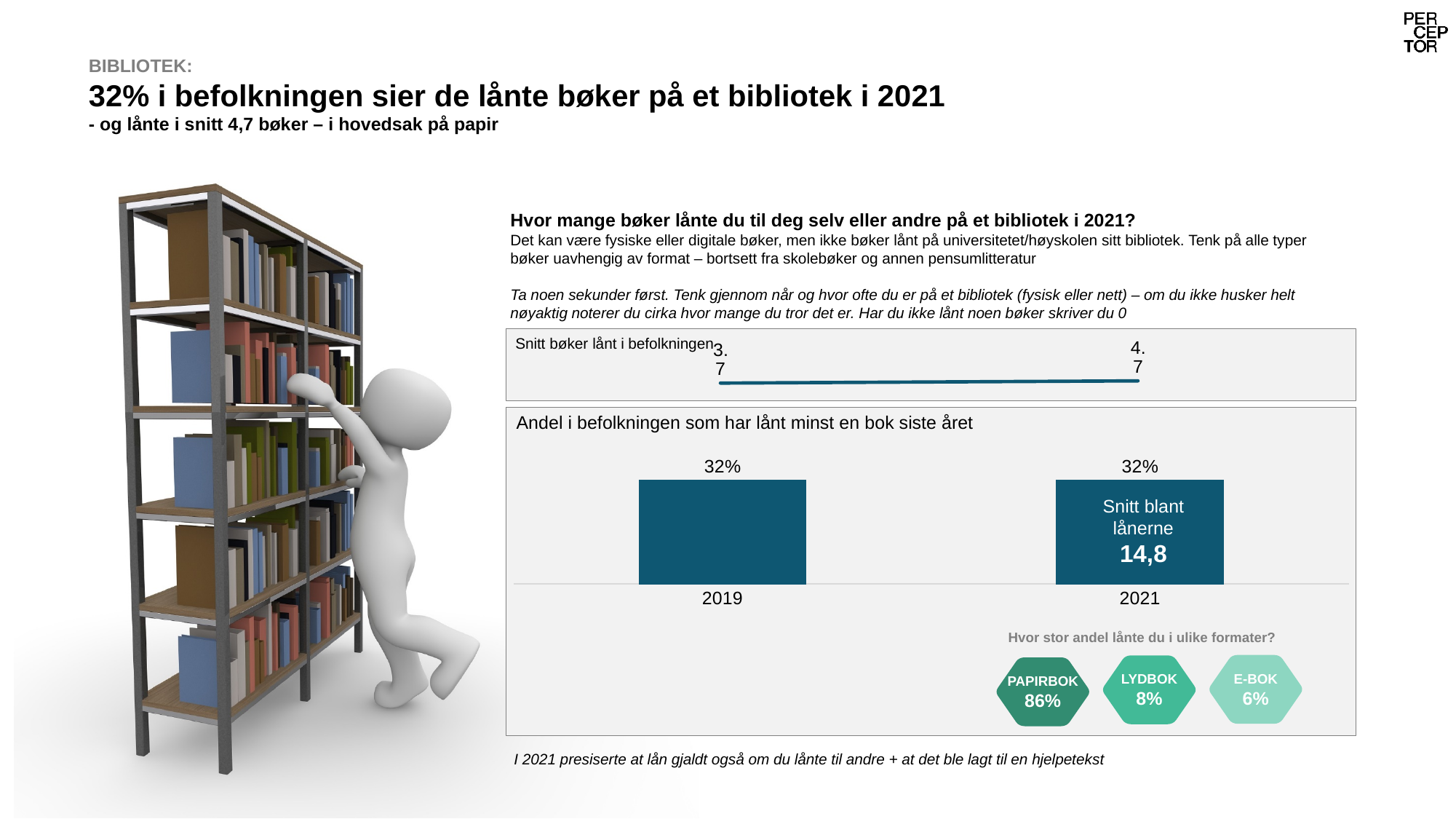
In the chart 'Snitt bøker lånt i befolkningen', does the value rise or fall from 2019 to 2021? Rises In the chart 'Andel i befolkningen som har lånt minst en bok siste året', what is the difference between the 2021 and 2019 values? 0 percentage points In the chart 'Snitt bøker lånt i befolkningen', what is the value for 2021? 4.7 In the chart 'Andel i befolkningen som har lånt minst en bok siste året', what is the value for 2019? 32% How many years are shown in the chart 'Andel i befolkningen som har lånt minst en bok siste året'? 2 In the chart 'Snitt bøker lånt i befolkningen', what is the value for 2019? 3.7 In the chart 'Andel i befolkningen som har lånt minst en bok siste året', is the value for 2019 or 2021 larger? They are equal (32%) In the chart 'Snitt bøker lånt i befolkningen', by how much did the value increase from 2019 to 2021? 1 In the chart 'Andel i befolkningen som har lånt minst en bok siste året', what is the value for 2021? 32% What kind of chart is 'Andel i befolkningen som har lånt minst en bok siste året'? Bar chart What kind of chart is 'Snitt bøker lånt i befolkningen'? Line chart In the chart 'Andel i befolkningen som har lånt minst en bok siste året', what is the 'Snitt blant lånerne' value shown inside the 2021 bar? 14,8